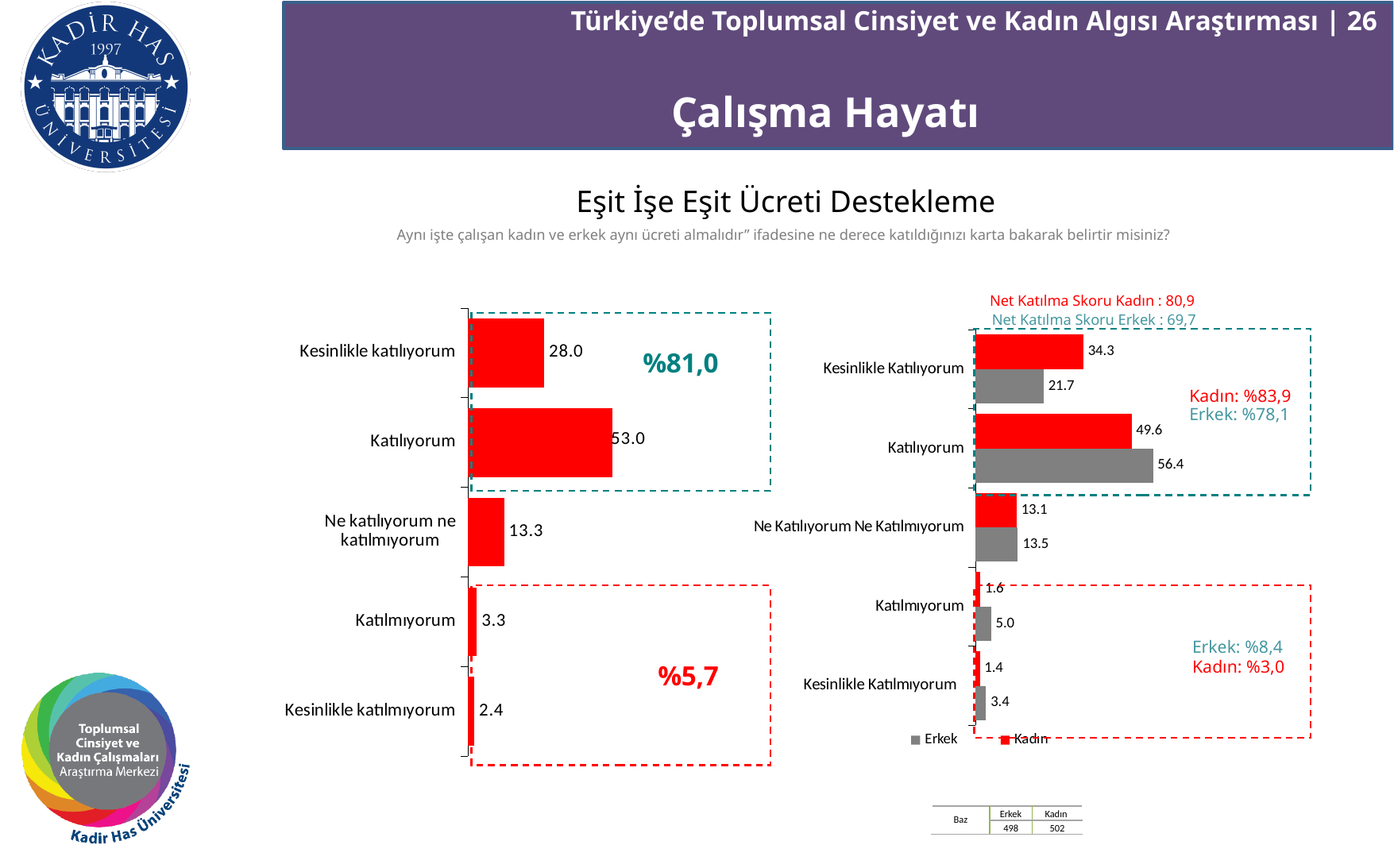
In the left chart, which category has the lowest value? Kesinlikle katılmıyorum In the left chart, what is the value for Katılıyorum? 53.0 In the right chart, which is larger for Katılmıyorum: Erkek or Kadın? Erkek How many series does the legend of the right chart list? 2 How many categories does the left chart show? 5 In the right chart, what is the Kadın value for Kesinlikle Katılıyorum? 34.3 In the left chart, what is the value for Kesinlikle katılmıyorum? 2.4 In the right chart, what is the Erkek value for Katılıyorum? 56.4 In the left chart, which category has the highest value? Katılıyorum In the left chart, what is the difference between Katılıyorum and Kesinlikle katılıyorum? 25.0 What type of chart is the right chart? Bar chart In the right chart, what is the difference between the Erkek and Kadın values for Kesinlikle Katılıyorum? 12.6